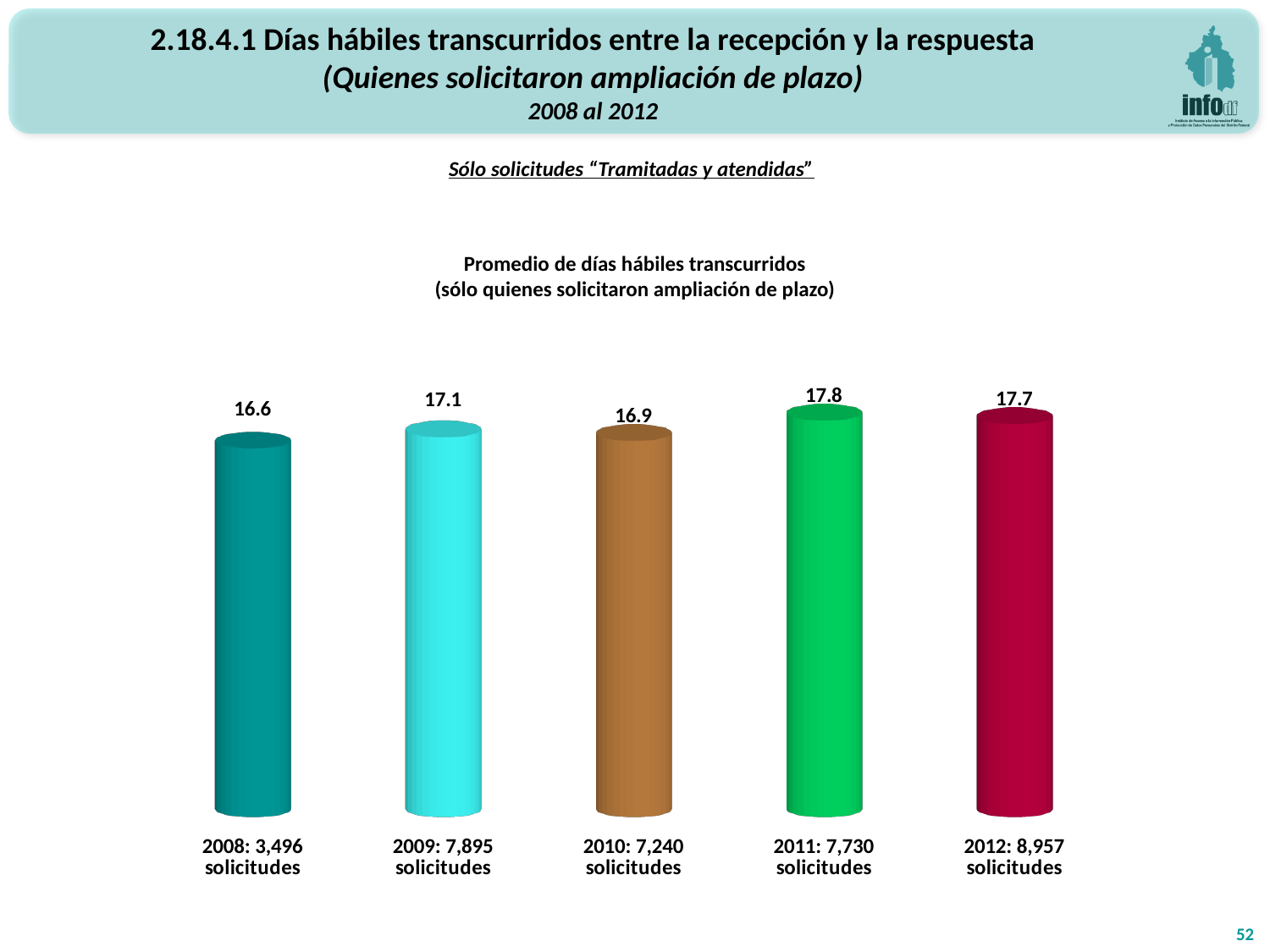
What is the difference between the values for 2011 and 2008? 1.2 How many years (bars) are shown in the chart? 5 How many solicitudes are indicated for 2012 in the category label? 8,957 What is the title of the chart? Promedio de días hábiles transcurridos (sólo quienes solicitaron ampliación de plazo) What is the value shown for 2012? 17.7 Which year has the highest average number of business days elapsed? 2011 Which is larger, the value for 2009 or the value for 2010? 2009 What is the difference between the values for 2009 and 2010? 0.2 What is the average number of business days elapsed for 2011? 17.8 What kind of chart is shown on the slide? Bar chart What is the average number of business days elapsed for 2008? 16.6 Which year has the lowest average number of business days elapsed? 2008